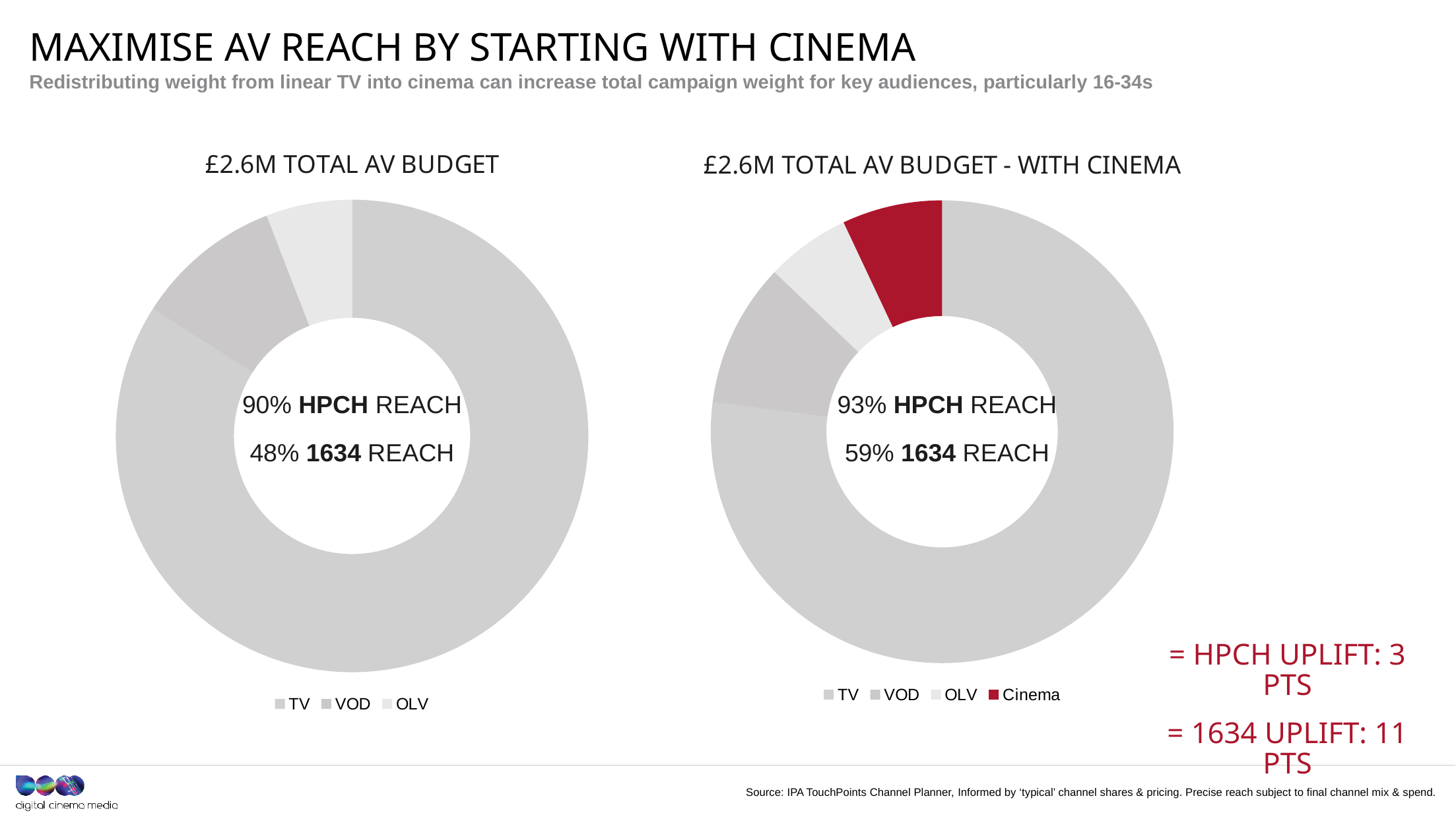
In the left chart, "£2.6M TOTAL AV BUDGET", which category has the smallest slice? OLV What 1634 reach is shown in the centre of the right chart, "£2.6M TOTAL AV BUDGET - WITH CINEMA"? 59% What colour is the Cinema slice in the right chart, "£2.6M TOTAL AV BUDGET - WITH CINEMA"? Red What HPCH reach is shown in the centre of the left chart, "£2.6M TOTAL AV BUDGET"? 90% What is the difference in 1634 reach between the right chart (with cinema) and the left chart? 11 pts How many categories does the legend of the left chart, "£2.6M TOTAL AV BUDGET", list? 3 In the right chart, "£2.6M TOTAL AV BUDGET - WITH CINEMA", which slice is larger: TV or VOD? TV In the left chart, "£2.6M TOTAL AV BUDGET", which category has the largest slice? TV Which category appears in the legend of the right chart but not in the legend of the left chart? Cinema What kind of chart is the "£2.6M TOTAL AV BUDGET" chart on the left? Doughnut (pie) chart How many categories does the legend of the right chart, "£2.6M TOTAL AV BUDGET - WITH CINEMA", list? 4 In the right chart, "£2.6M TOTAL AV BUDGET - WITH CINEMA", which category has the largest slice? TV